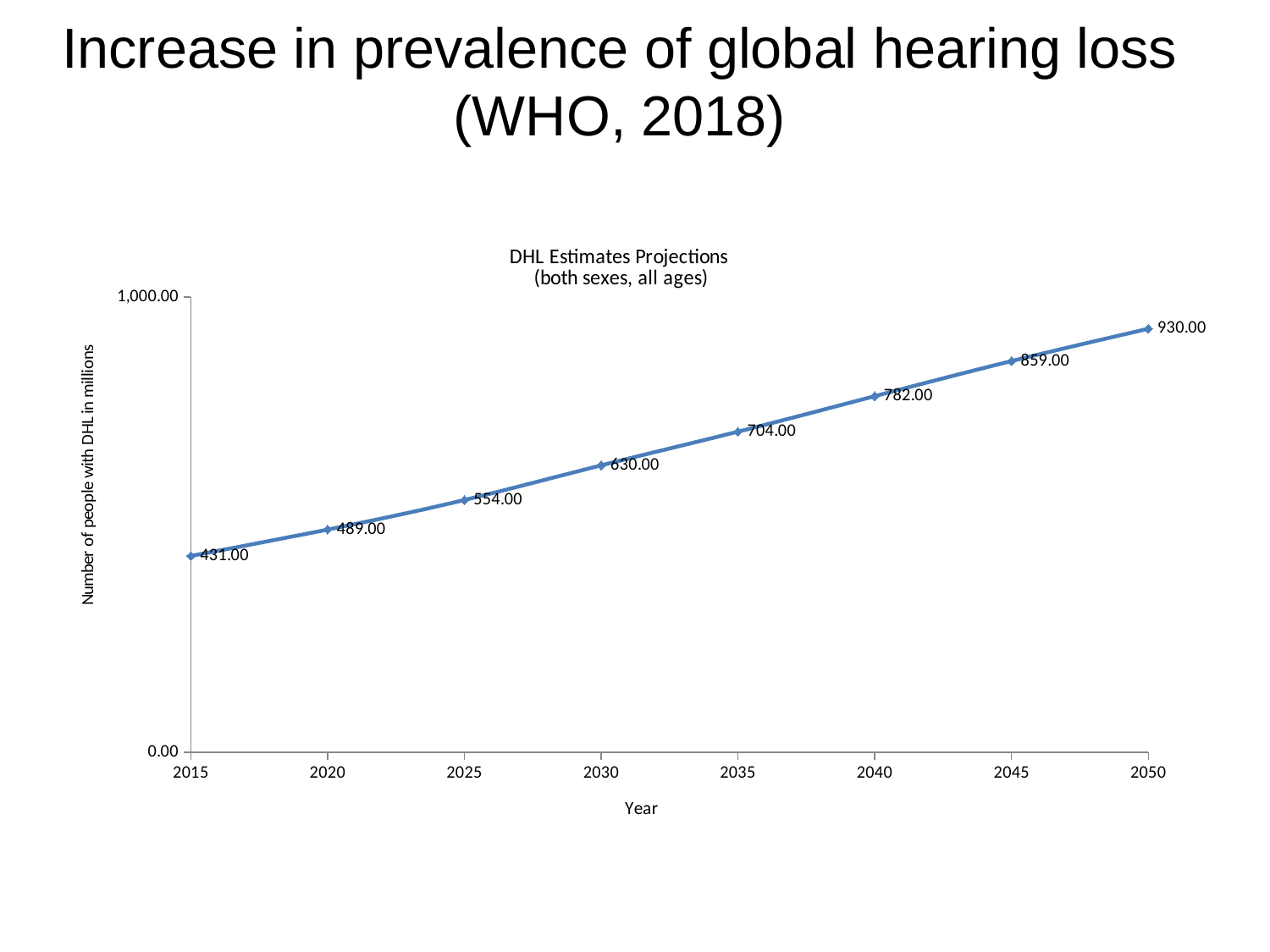
What kind of chart is shown? line chart What is the value for 2030? 630.00 What is the value for 2015? 431.00 Do the values rise or fall from 2015 to 2050? rise What is the difference between the values for 2050 and 2015? 499.00 Which year has the highest value? 2050 Which is larger, the value for 2045 or the value for 2020? 2045 Which year has the lowest value? 2015 How many data points are plotted on the chart? 8 What is the value for 2040? 782.00 What is the difference between the values for 2035 and 2025? 150.00 What is the value for 2050? 930.00